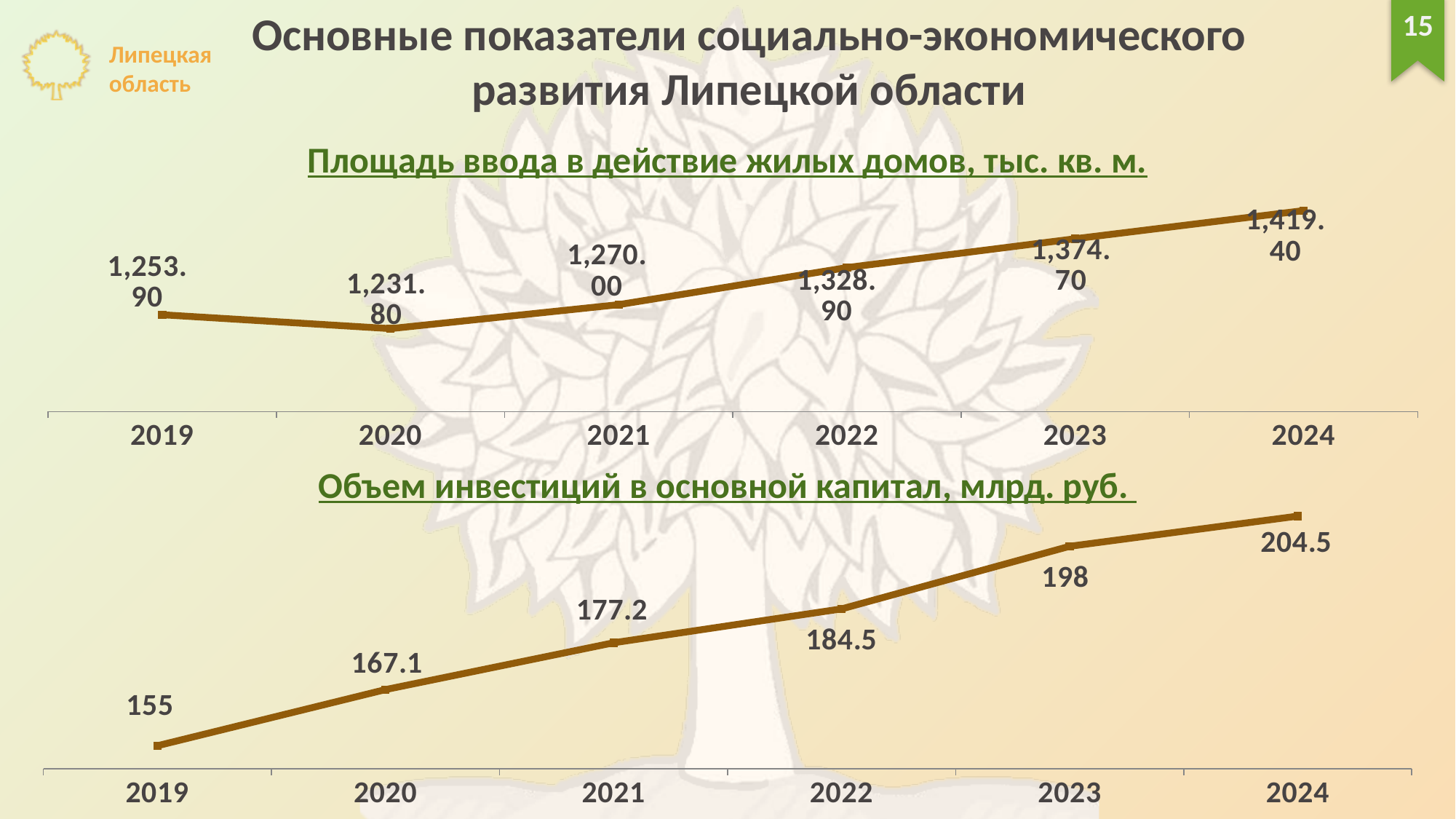
In the chart 'Объем инвестиций в основной капитал, млрд. руб.', what is the value for 2019? 155 What kind of chart is the top chart on the slide? line chart In the chart 'Площадь ввода в действие жилых домов, тыс. кв. м.', which year has the highest value? 2024 In the chart 'Объем инвестиций в основной капитал, млрд. руб.', do the values rise or fall from 2019 to 2024? rise In the chart 'Объем инвестиций в основной капитал, млрд. руб.', what is the value for 2021? 177.2 What is the title of the bottom chart on the slide? Объем инвестиций в основной капитал, млрд. руб. In the chart 'Площадь ввода в действие жилых домов, тыс. кв. м.', what is the difference between the 2024 and 2019 values? 165.50 In the chart 'Объем инвестиций в основной капитал, млрд. руб.', what is the difference between the 2023 and 2022 values? 13.5 In the chart 'Площадь ввода в действие жилых домов, тыс. кв. м.', is the value for 2019 or 2020 larger? 2019 In the chart 'Площадь ввода в действие жилых домов, тыс. кв. м.', what is the value for 2022? 1,328.90 In the chart 'Площадь ввода в действие жилых домов, тыс. кв. м.', which year has the lowest value? 2020 How many years are plotted in the chart 'Объем инвестиций в основной капитал, млрд. руб.'? 6